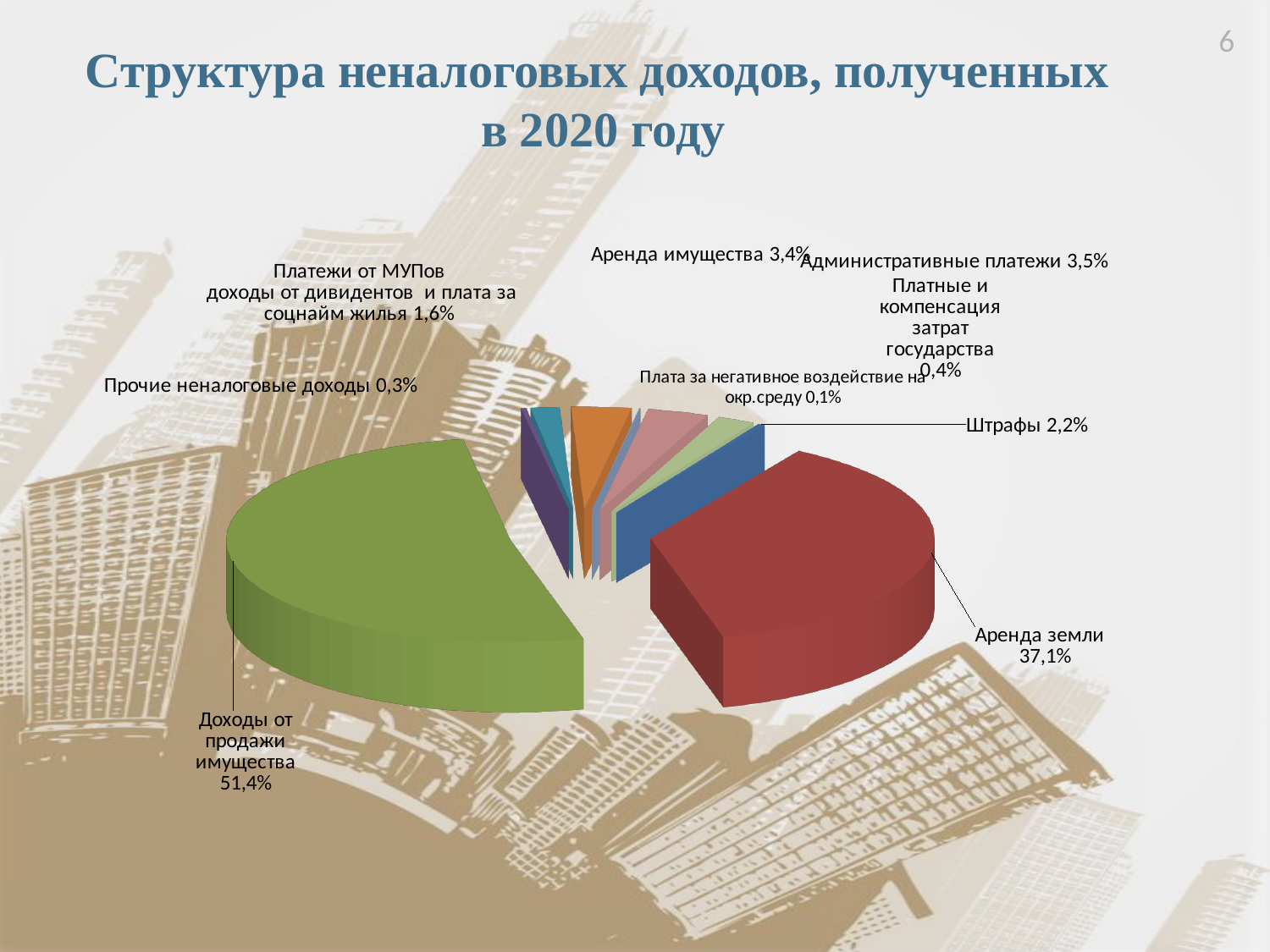
Which category has the largest share of non-tax revenue in 2020? Доходы от продажи имущества What is the difference in percentage points between «Доходы от продажи имущества» and «Аренда земли»? 14,3 What percentage is shown for «Плата за негативное воздействие на окр.среду»? 0,1% What percentage is shown for «Административные платежи»? 3,5% What type of chart is shown on the slide? Pie chart What is the title of the slide containing the pie chart? Структура неналоговых доходов, полученных в 2020 году What share does «Аренда земли» have in the pie chart? 37,1% What percentage is shown for «Штрафы»? 2,2% How many categories (slices) does the pie chart contain? 9 What share of non-tax revenue in 2020 came from «Доходы от продажи имущества»? 51,4% Which is larger: the share of «Аренда имущества» or the share of «Штрафы»? Аренда имущества Which category has the smallest share in the pie chart? Плата за негативное воздействие на окр.среду